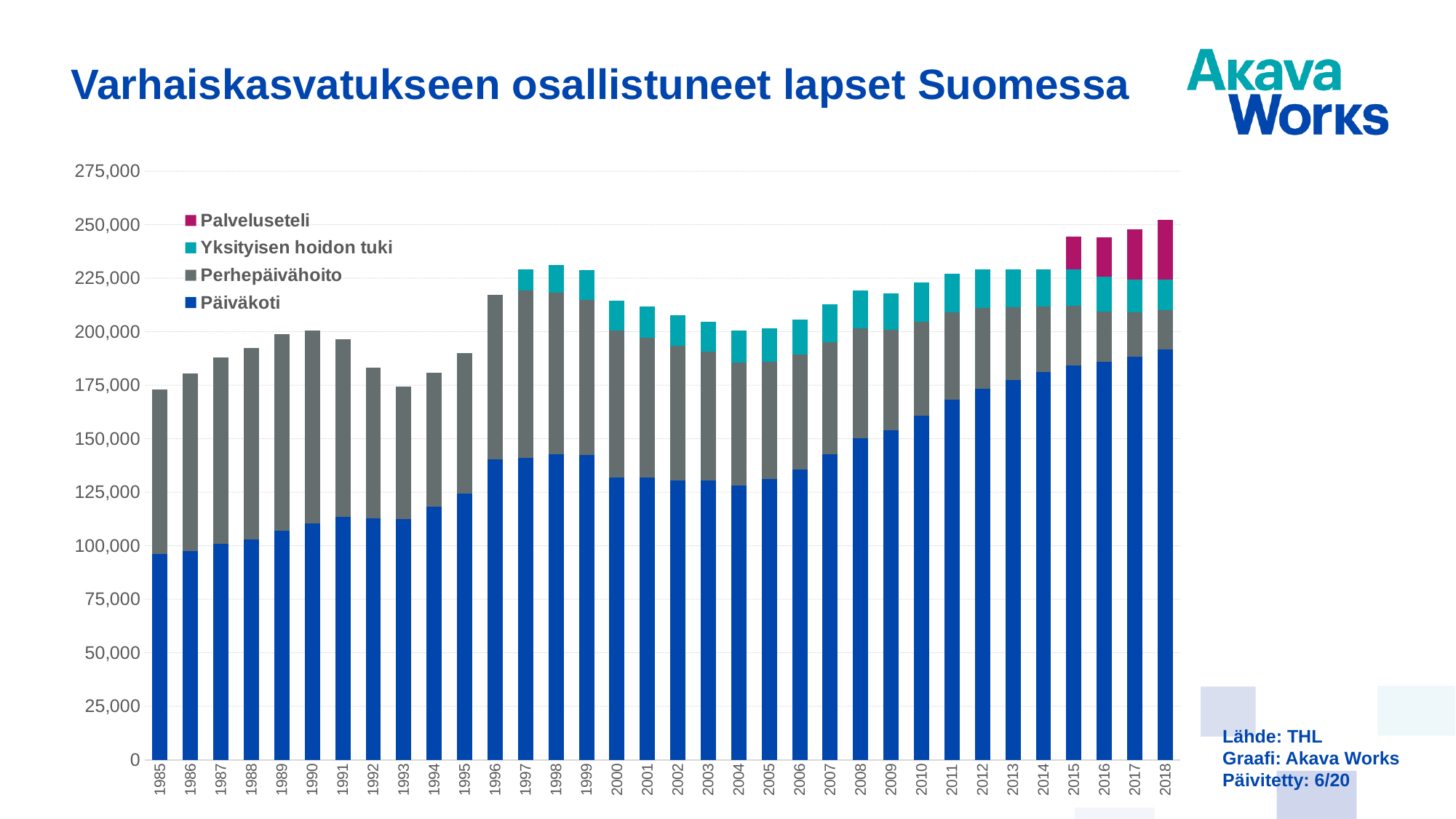
Is the Päiväkoti value for 1985 greater or less than 100,000? less What kind of chart is shown on the slide? Stacked bar chart Does the Päiväkoti value rise or fall from 2004 to 2018? Rise Which year has the highest Päiväkoti value? 2018 Which is larger, the total bar for 1998 or the total bar for 2004? 1998 Is the total bar for 1998 greater or less than 225,000? greater Which year has the highest total bar? 2018 Is the total bar for 1993 greater or less than 200,000? less Which series is listed first (at the top) in the legend? Palveluseteli How many series does the legend list? 4 How many years are shown on the x axis? 34